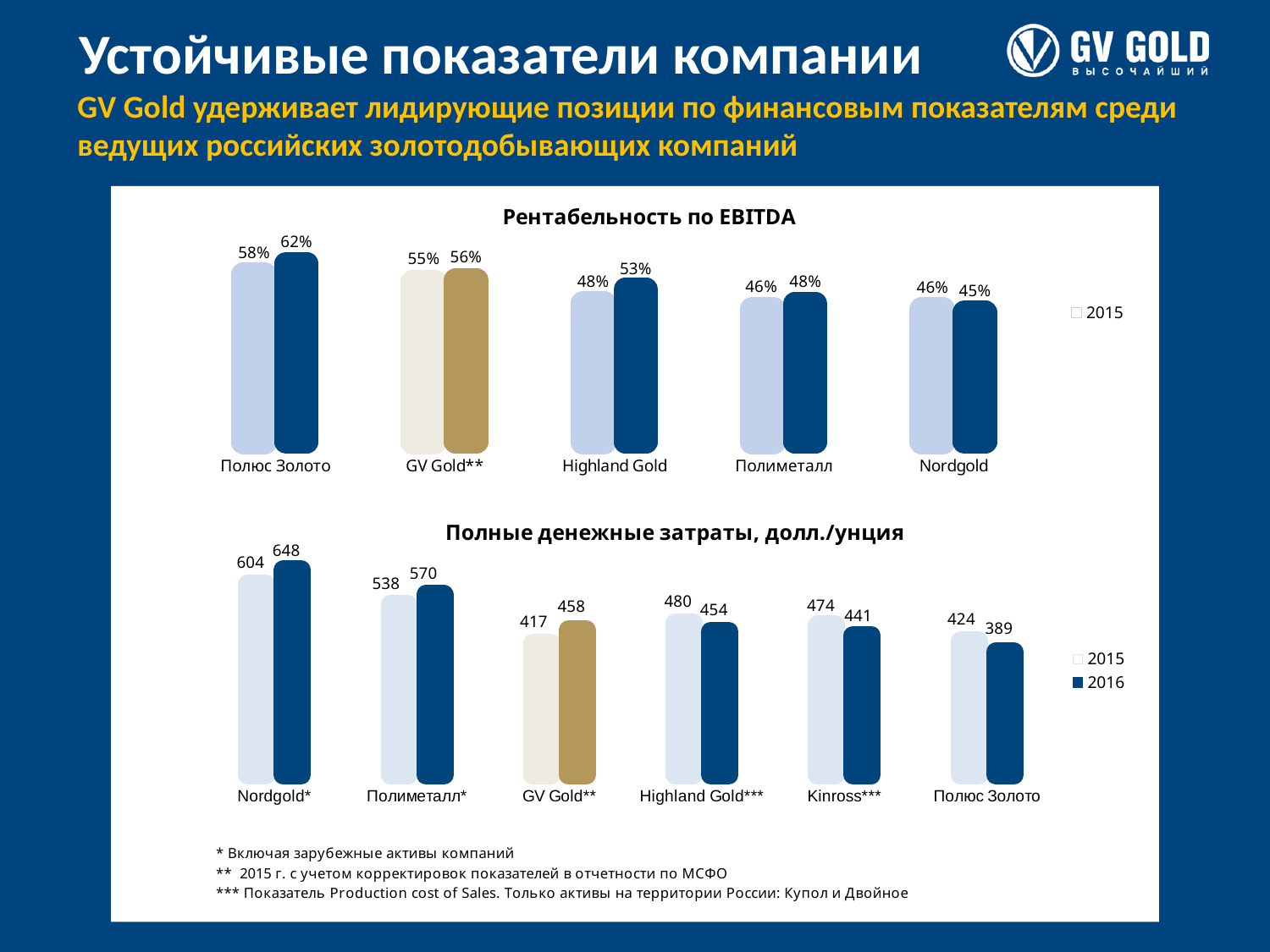
In the 'Полные денежные затраты, долл./унция' chart, what is the difference between the 2016 and 2015 values for Nordgold*? 44 In the 'Рентабельность по EBITDA' chart, what is the difference between the 2016 and 2015 values for Highland Gold? 5% In the 'Рентабельность по EBITDA' chart, how many companies are shown on the x axis? 5 In the 'Рентабельность по EBITDA' chart, what is the 2015 value for GV Gold**? 55% In the 'Рентабельность по EBITDA' chart, what is the 2016 value for Полюс Золото? 62% What kind of chart is the 'Полные денежные затраты, долл./унция' chart? Bar chart In the 'Полные денежные затраты, долл./унция' chart, how many series does the legend list? 2 In the 'Полные денежные затраты, долл./унция' chart, what is the 2015 value for Kinross***? 474 In the 'Полные денежные затраты, долл./унция' chart, what is the 2016 value for GV Gold**? 458 In the 'Полные денежные затраты, долл./унция' chart, which company has the lowest 2016 value? Полюс Золото In the 'Полные денежные затраты, долл./унция' chart, which company has the highest 2015 value? Nordgold* In the 'Рентабельность по EBITDA' chart, which company has the highest 2016 value? Полюс Золото